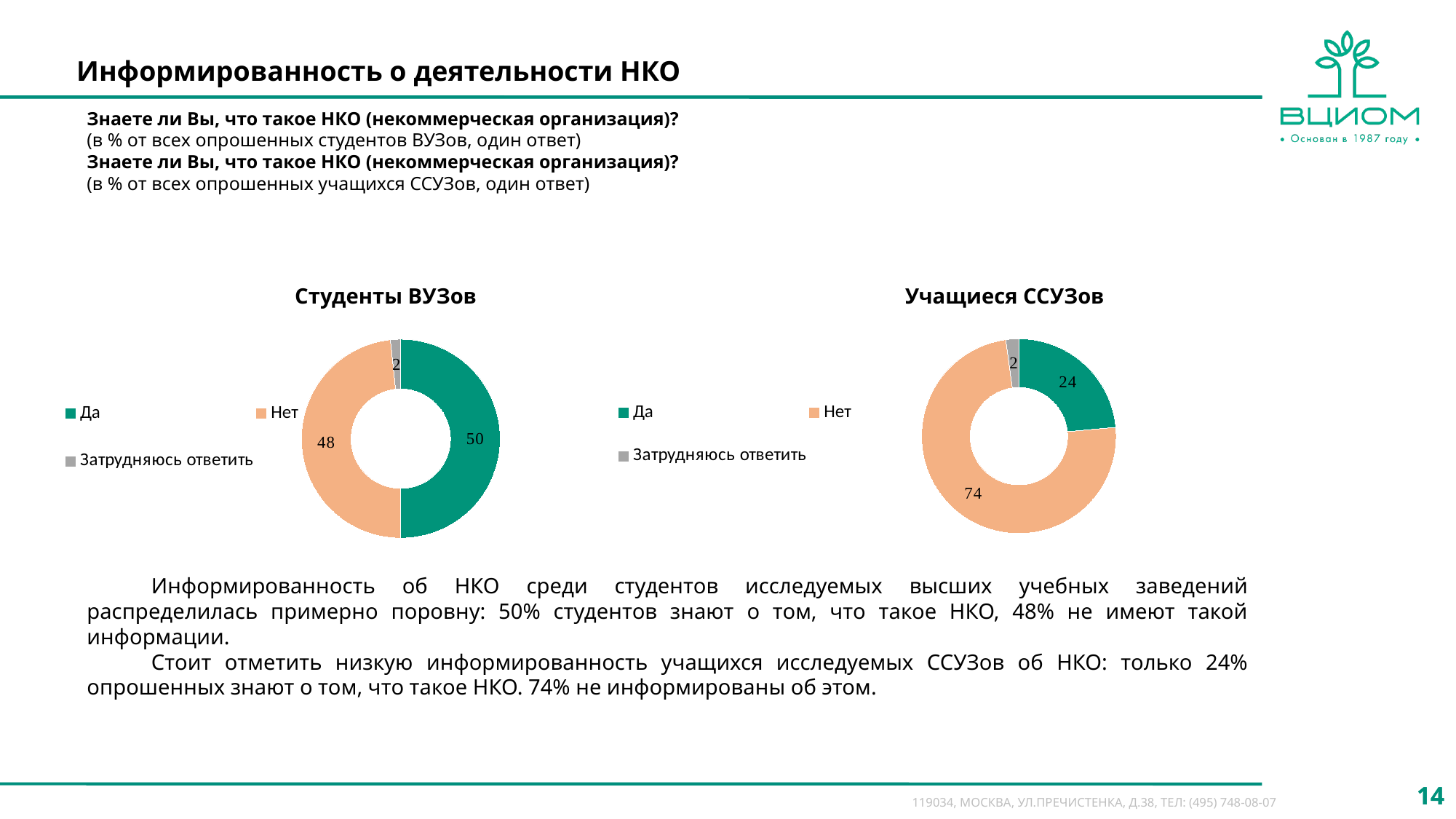
In the 'Студенты ВУЗов' chart, what is the value for 'Нет'? 48 In the 'Студенты ВУЗов' chart, what colour represents 'Нет'? Orange (peach) In the 'Учащиеся ССУЗов' chart, what is the difference between 'Нет' and 'Да'? 50 In the 'Учащиеся ССУЗов' chart, what is the value for 'Затрудняюсь ответить'? 2 In the 'Студенты ВУЗов' chart, which category has the smallest share? Затрудняюсь ответить In the 'Учащиеся ССУЗов' chart, which category has the largest share? Нет How many categories does the 'Студенты ВУЗов' chart show? 3 In the 'Учащиеся ССУЗов' chart, what is the value for 'Да'? 24 What kind of chart is the 'Учащиеся ССУЗов' chart? Doughnut (pie) chart In the 'Студенты ВУЗов' chart, what is the value for 'Да'? 50 In the 'Учащиеся ССУЗов' chart, what is the value for 'Нет'? 74 Is the value for 'Да' larger in the 'Студенты ВУЗов' chart or in the 'Учащиеся ССУЗов' chart? Студенты ВУЗов